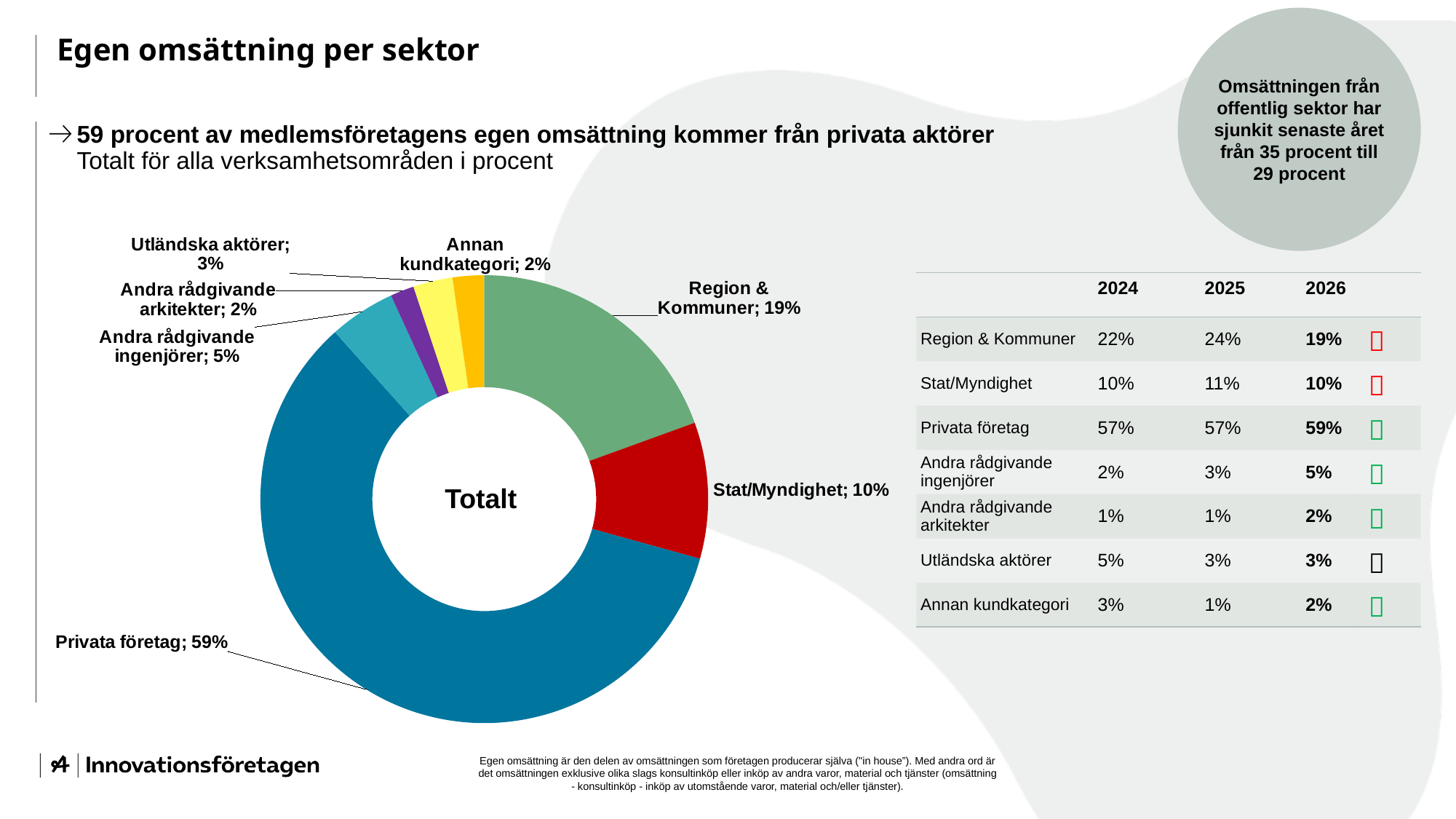
What colour is the Stat/Myndighet slice in the pie chart? Red What is the difference between the Region & Kommuner slice and the Stat/Myndighet slice? 9% What is the value shown for Stat/Myndighet in the pie chart? 10% What share of the pie chart does Privata företag have? 59% What text is shown in the centre of the donut chart? Totalt Which is larger in the pie chart, Andra rådgivande ingenjörer or Utländska aktörer? Andra rådgivande ingenjörer What is the value shown for Andra rådgivande ingenjörer in the pie chart? 5% What is the value shown for Region & Kommuner in the pie chart? 19% What is the value shown for Utländska aktörer in the pie chart? 3% What kind of chart is shown on the slide? Pie chart (donut) How many slices does the pie chart have? 7 Which category has the largest slice in the pie chart? Privata företag